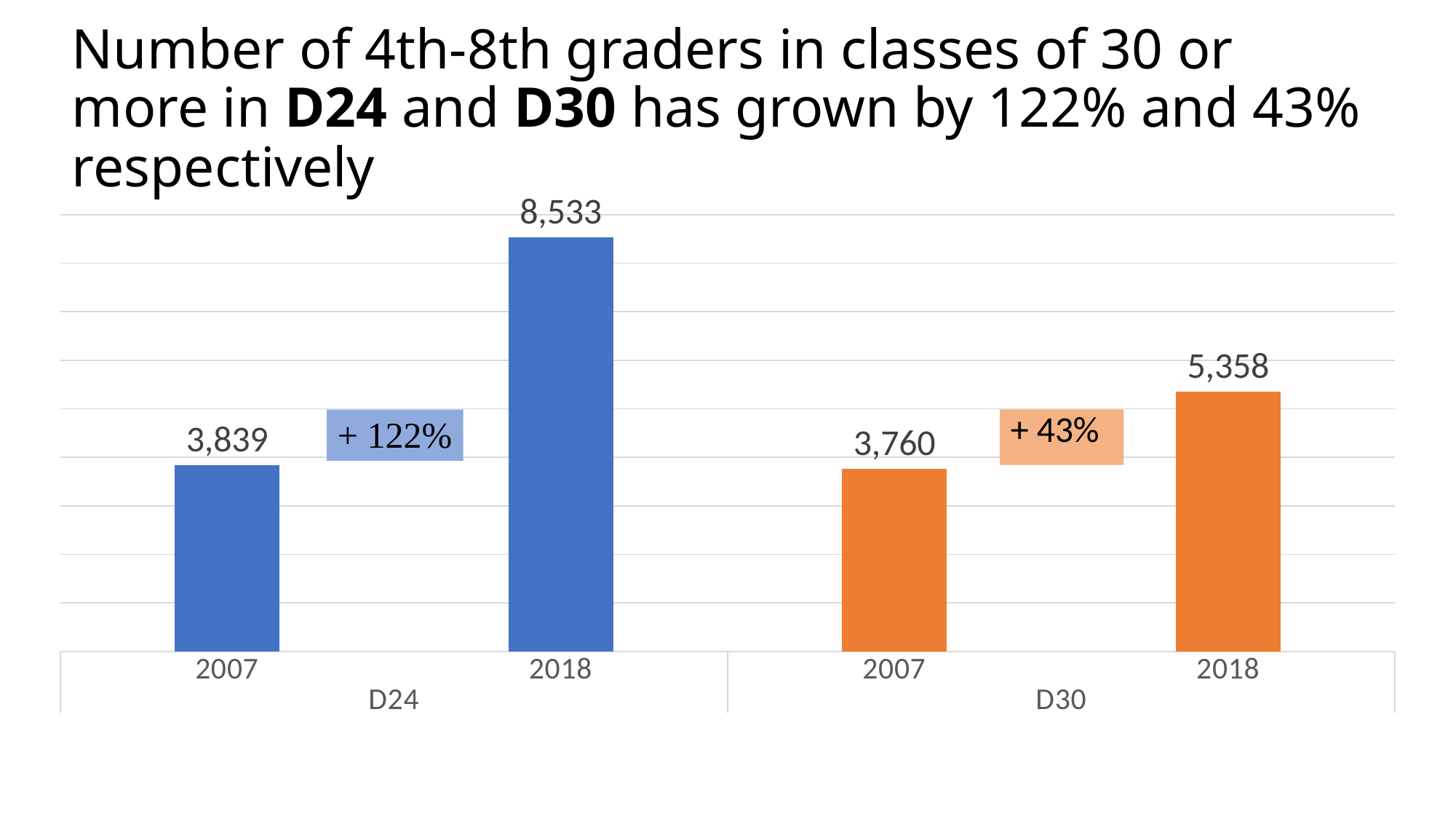
What percentage growth is annotated for D30 between 2007 and 2018? + 43% What is the value for D30 in 2007? 3,760 What is the value for D24 in 2018? 8,533 What is the difference between the D30 values for 2018 and 2007? 1,598 Which bar has the highest value? D24 2018 Which is larger, the 2018 value for D24 or the 2018 value for D30? D24 What is the difference between the D24 values for 2018 and 2007? 4,694 Which bar has the lowest value? D30 2007 What kind of chart is shown on the slide? Bar chart How many bars are plotted in the chart? 4 What is the value for D24 in 2007? 3,839 What is the value for D30 in 2018? 5,358